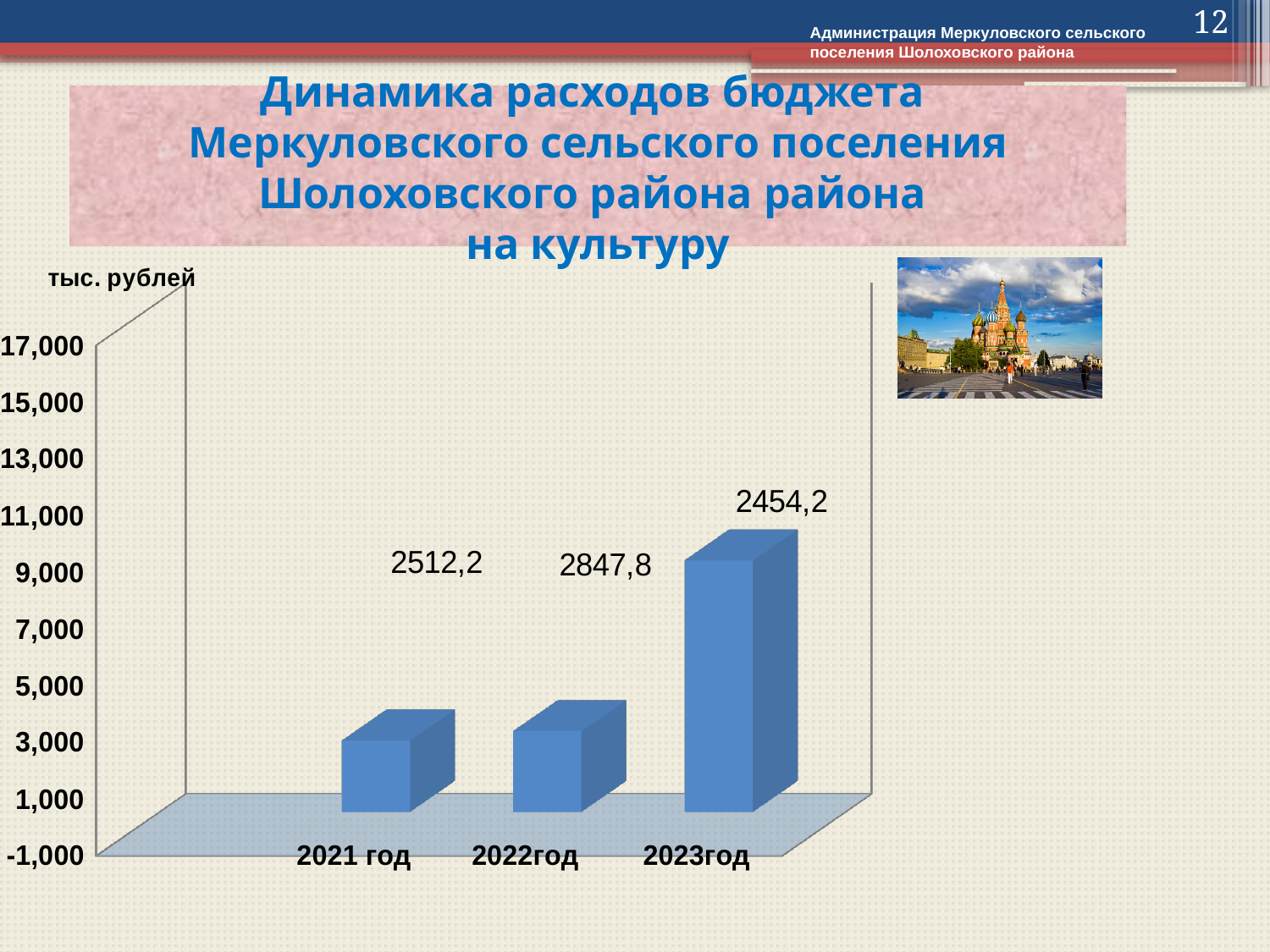
What unit is indicated above the vertical axis of the chart? тыс. рублей What is the difference between the values for 2022год and 2021 год? 335,6 How many categories (years) are shown on the chart? 3 What is the value for 2023год? 2454,2 What is the highest tick value shown on the vertical axis? 17,000 What kind of chart is shown on the slide? bar chart What is the value for 2022год? 2847,8 What is the value for 2021 год? 2512,2